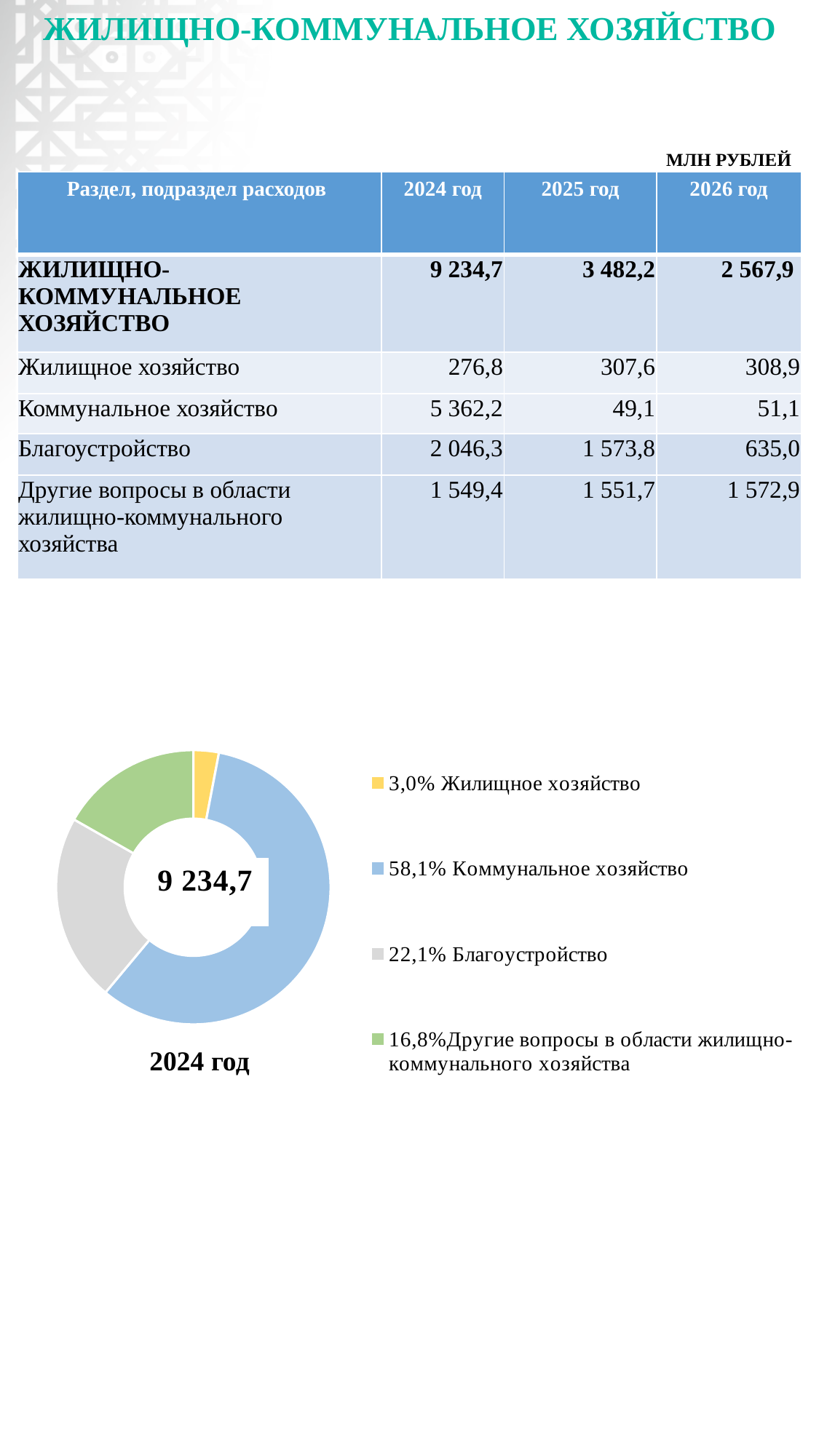
What share of the doughnut chart does Благоустройство take? 22,1% What value is printed in the centre of the doughnut chart? 9 234,7 How many categories does the doughnut chart show? 4 Which category has the largest slice in the doughnut chart? Коммунальное хозяйство What kind of chart is shown on the slide? doughnut chart What share of the doughnut chart does Другие вопросы в области жилищно-коммунального хозяйства take? 16,8% Which category has the smallest slice in the doughnut chart? Жилищное хозяйство What share of the doughnut chart does Коммунальное хозяйство take? 58,1% Which year is the doughnut chart labelled with? 2024 год What is the difference in percentage points between the Коммунальное хозяйство and Благоустройство slices? 36,0% Which slice is larger in the doughnut chart: Благоустройство or Другие вопросы в области жилищно-коммунального хозяйства? Благоустройство